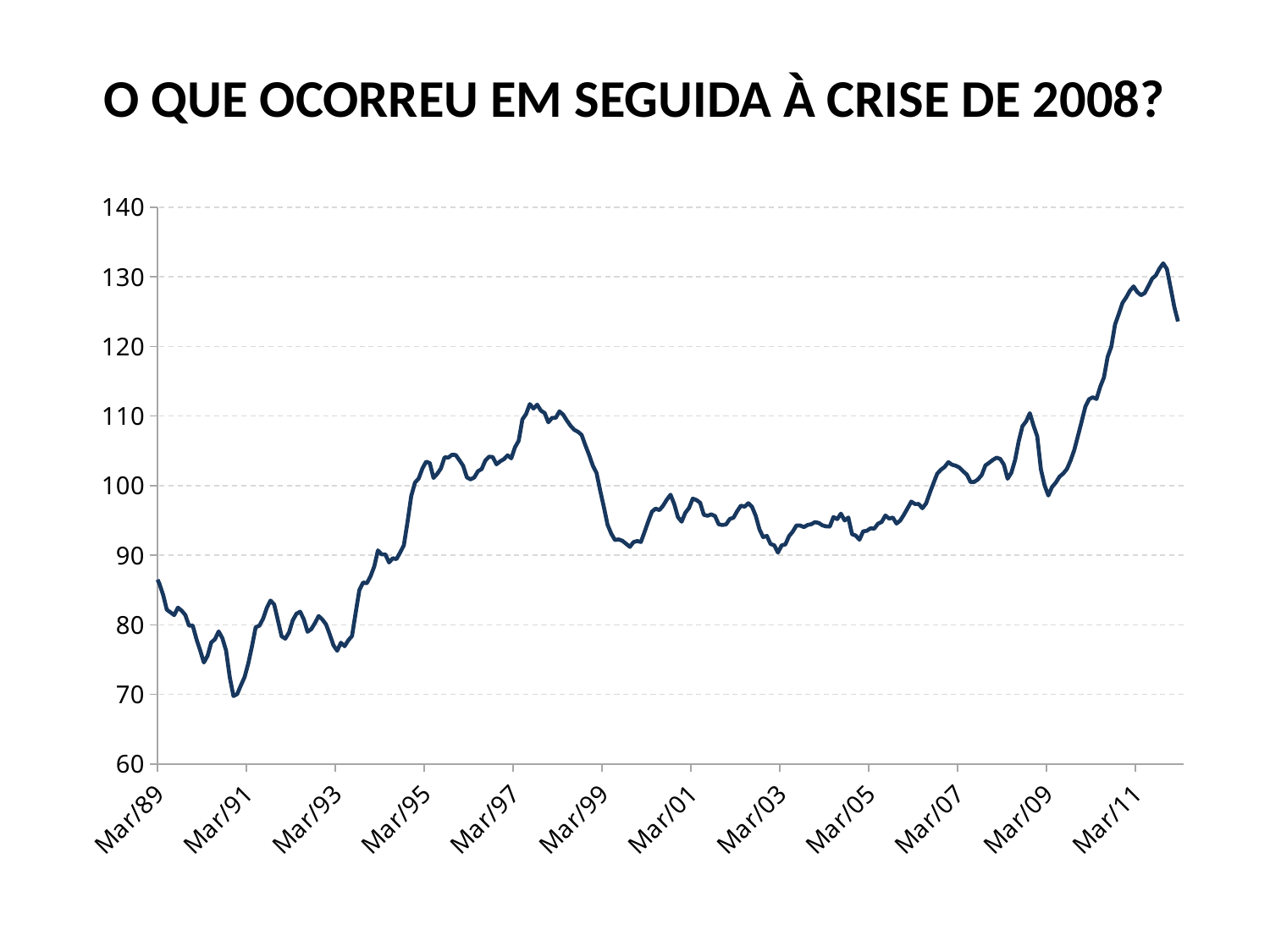
Is the lowest point of the line closer to Mar/91 or Mar/93? Mar/91 How many date labels are shown on the x axis? 12 Does the line rise or fall between Mar/09 and Mar/11? rise What is the title of the slide? O QUE OCORREU EM SEGUIDA À CRISE DE 2008? Is the highest point of the line closer to Mar/09 or Mar/11? Mar/11 What kind of chart is shown on the slide? line chart Is the value at Mar/05 greater or less than 100? less Is the value at Mar/89 greater or less than 80? greater Is the value at Mar/11 greater or less than 120? greater